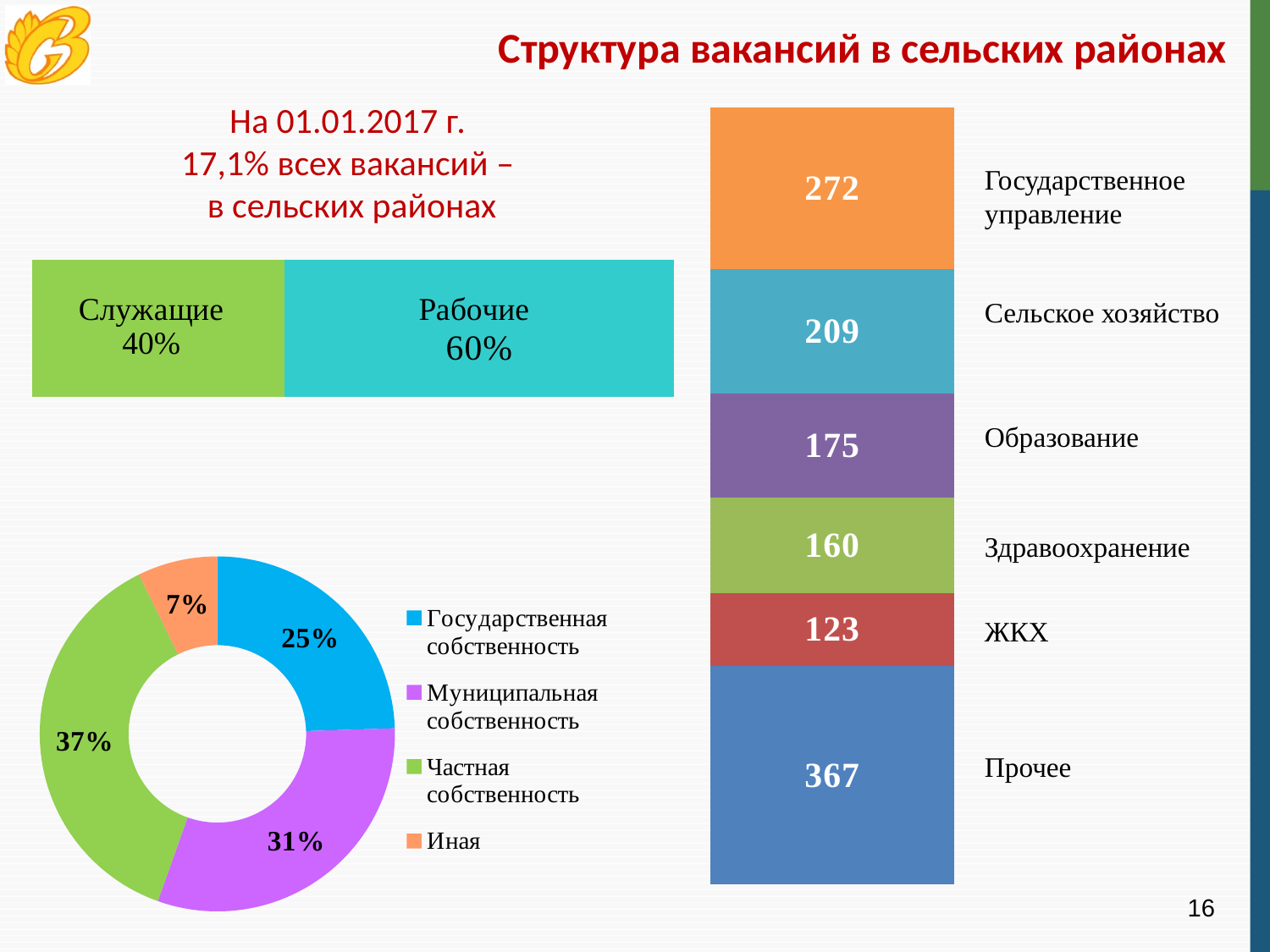
In the doughnut chart at the bottom left, which category has the smallest share? Иная In the doughnut chart at the bottom left, what share is Частная собственность? 37% In the horizontal bar at the top left, what share is Рабочие? 60% In the doughnut chart at the bottom left, which category has the largest share? Частная собственность In the doughnut chart at the bottom left, what is the difference between Муниципальная собственность and Государственная собственность? 6% In the stacked bar chart on the right, what is the total of all segments? 1306 In the doughnut chart at the bottom left, what share is Государственная собственность? 25% In the stacked bar chart on the right, what is the value for ЖКХ? 123 In the stacked bar chart on the right, which category has the largest value? Прочее In the stacked bar chart on the right, which is larger: Образование or Здравоохранение? Образование How many entries does the legend of the doughnut chart at the bottom left list? 4 In the stacked bar chart on the right, what is the value for Сельское хозяйство? 209